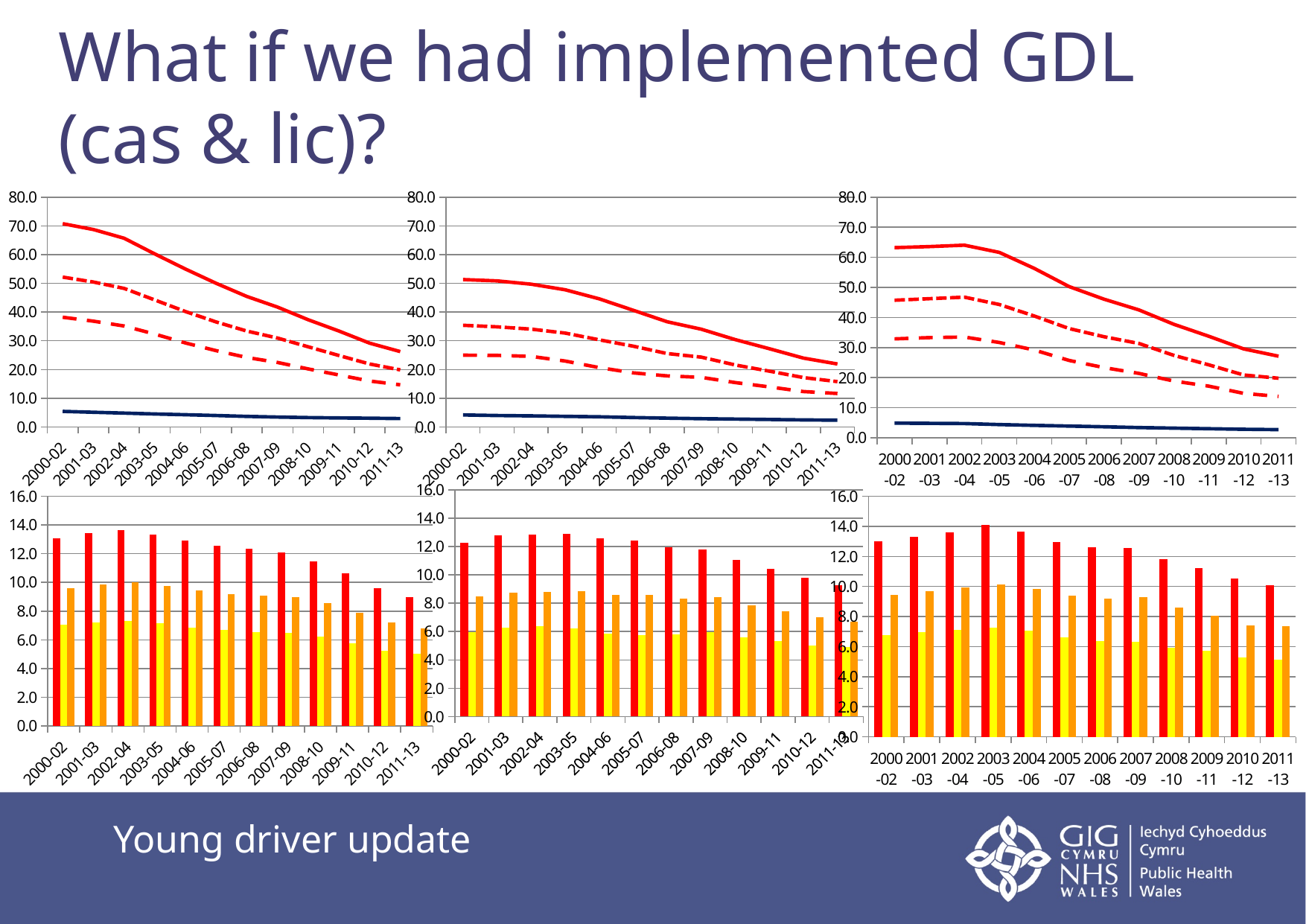
In the top-right line chart, is the value of the solid red line at 2011-13 greater or less than 30? less In the top-middle line chart, is the value of the solid red line at 2011-13 greater or less than 30? less In the bottom-left bar chart, which year has the lowest red bar? 2011-13 How many charts are shown on the slide? 6 In the bottom-left bar chart, is the orange bar for 2011-13 greater or less than 8? less In the bottom-right bar chart, which year has the highest red bar? 2003-05 In the bottom-left bar chart, how many year categories are shown on the x axis? 12 In the top-left line chart, does the solid red line rise or fall from 2000-02 to 2011-13? fall What kind of chart is the top-left chart? line chart What kind of chart is the bottom-left chart? bar chart